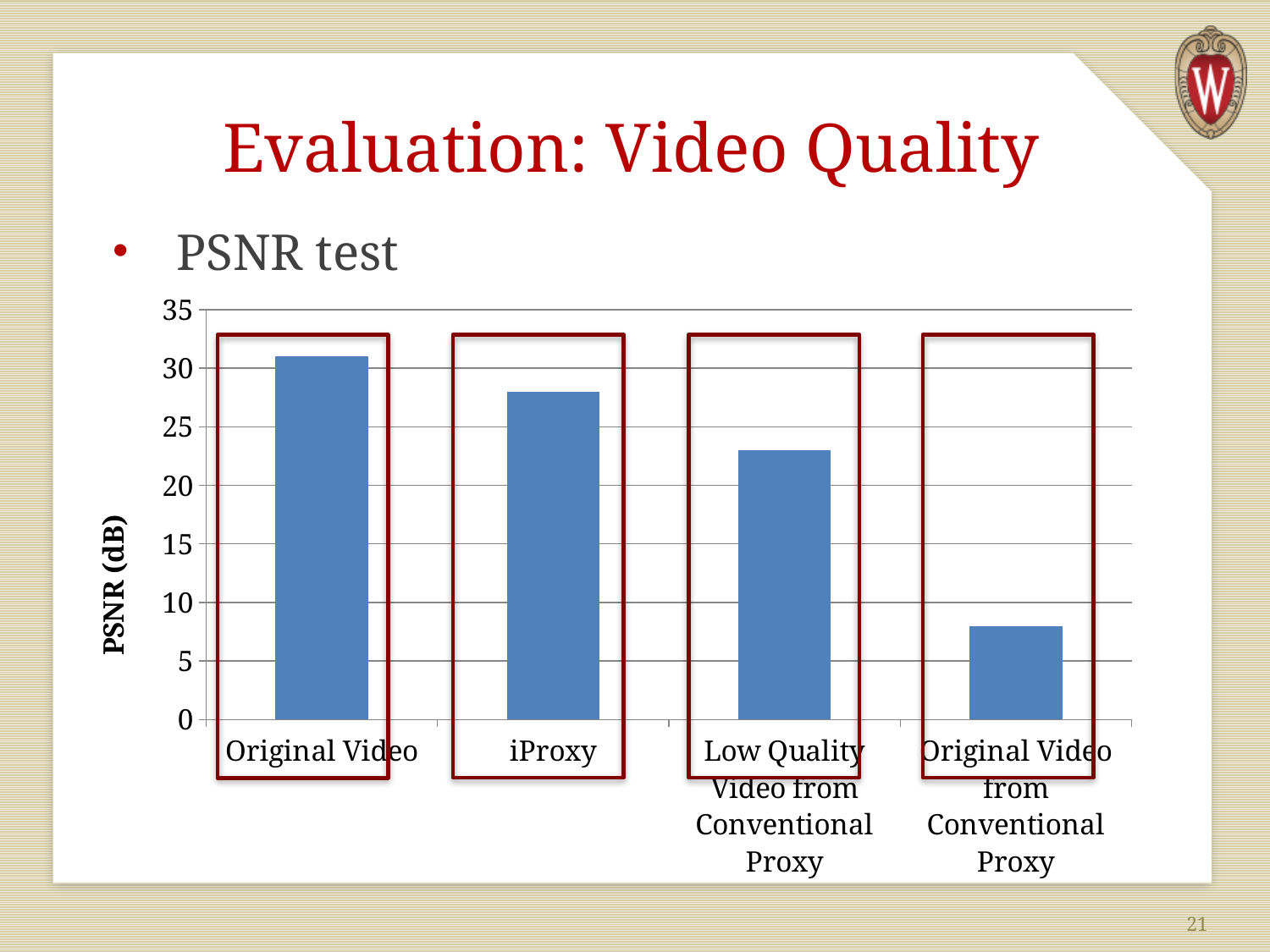
Do the PSNR values rise or fall moving from left to right across the categories? fall Which category has the highest PSNR value? Original Video Is the PSNR value for Original Video greater or less than 30? greater Is the PSNR value for iProxy greater or less than 25? greater How many categories are plotted on the chart? 4 What is the label of the vertical axis? PSNR (dB) What kind of chart is shown on the slide? bar chart Is the PSNR value for Original Video from Conventional Proxy greater or less than 10? less Which has a higher PSNR value, iProxy or Low Quality Video from Conventional Proxy? iProxy Which category has the lowest PSNR value? Original Video from Conventional Proxy What is the maximum value shown on the vertical axis? 35